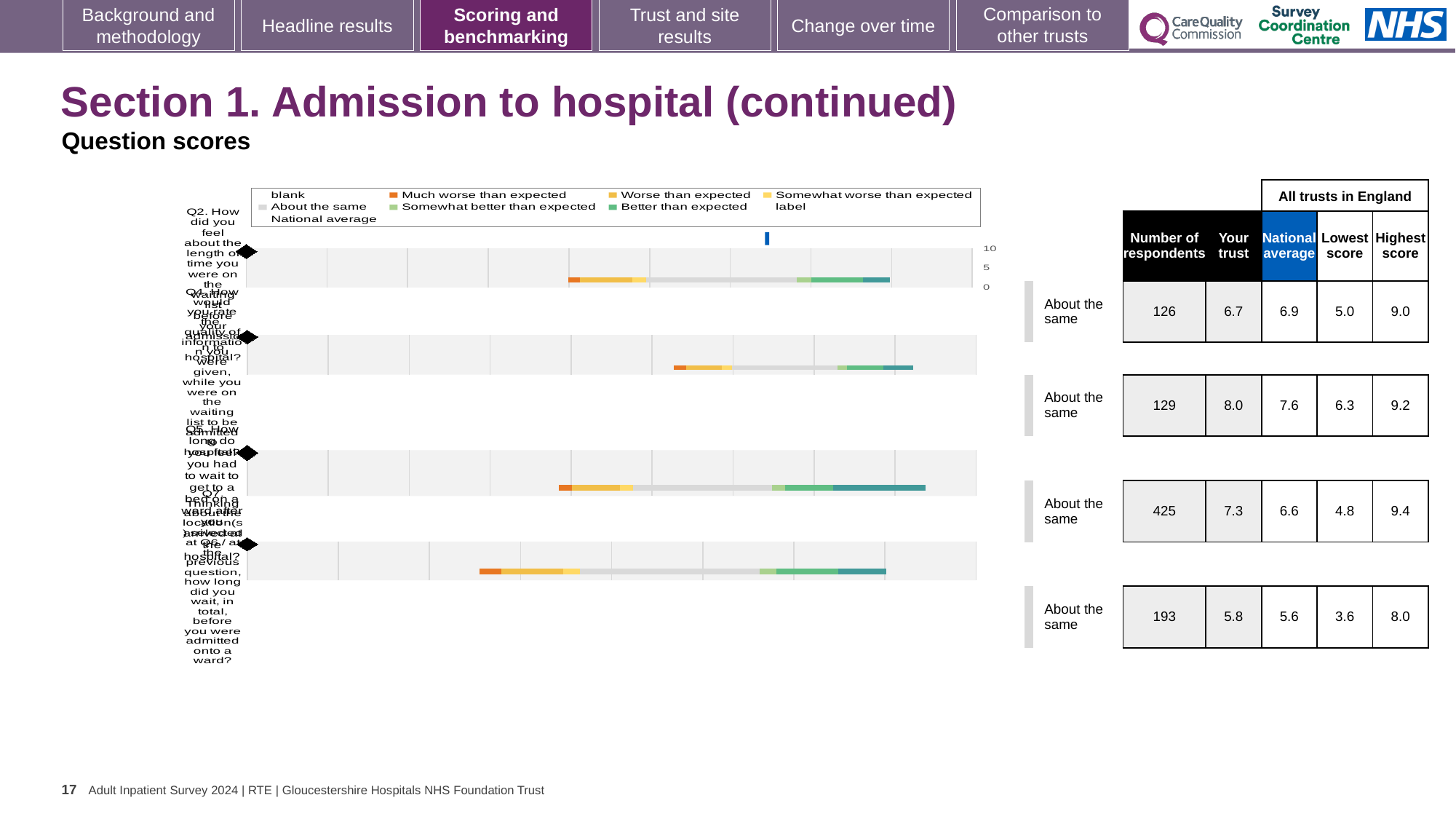
In the first row, which is larger: the 'Your trust' score or the 'National average'? National average Which row of the table has the highest number of respondents? the third row (425) How many question rows are plotted in the chart? 4 In the third row, which is larger: the 'Your trust' score or the 'National average'? Your trust In the third row, what is the difference between the highest score and the lowest score? 4.6 What kind of chart is shown on the slide? bar chart Which row has the lowest value in the 'Lowest score' column? the fourth row (3.6) What is the 'Your trust' score for the second row of the table? 8.0 What is the number of respondents for the first (top) row of the table? 126 What is the national average for the fourth (bottom) row of the table? 5.6 What benchmark category is shown for every question row on the slide? About the same What heading spans the National average, Lowest score and Highest score columns of the table? All trusts in England